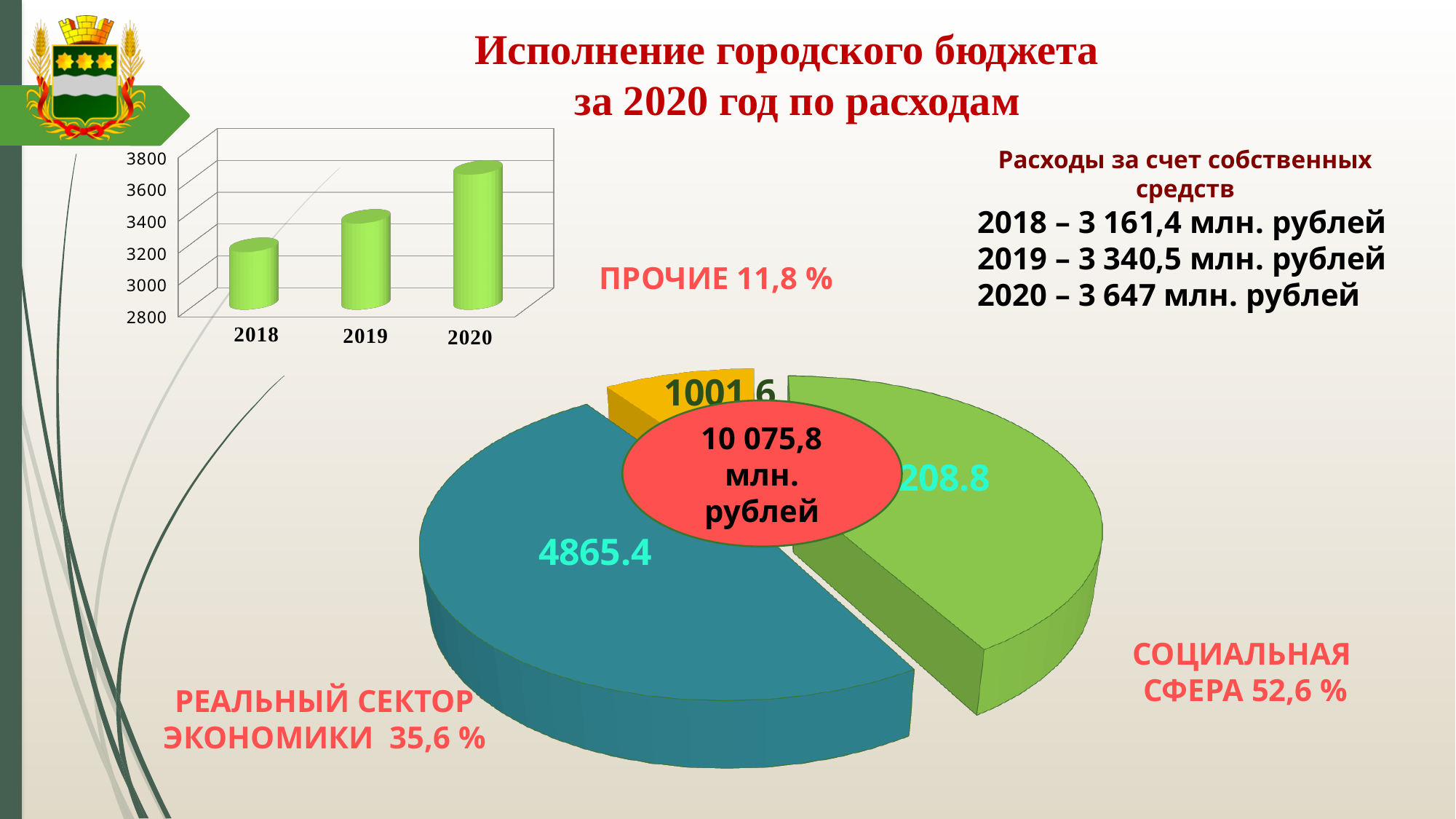
In the bar chart in the upper left, which year has the highest bar? 2020 In the bar chart in the upper left, how many years are plotted? 3 In the bar chart in the upper left, is the value for 2020 greater or less than 3600? greater In the bar chart in the upper left, which year has the lowest bar? 2018 In the pie chart, what value is labelled on the ПРОЧИЕ slice? 1001.6 In the bar chart in the upper left, is the value for 2018 greater or less than 3400? less In the bar chart in the upper left, do the values rise or fall from 2018 to 2020? rise In the pie chart, what value is labelled on the РЕАЛЬНЫЙ СЕКТОР ЭКОНОМИКИ slice? 4865.4 In the pie chart, which category has the smallest slice? ПРОЧИЕ In the pie chart, what share does СОЦИАЛЬНАЯ СФЕРА have? 52,6 % In the pie chart, what total is shown in the red oval at the centre? 10 075,8 млн. рублей What kind of chart is the chart in the upper left showing the years 2018, 2019 and 2020? bar chart